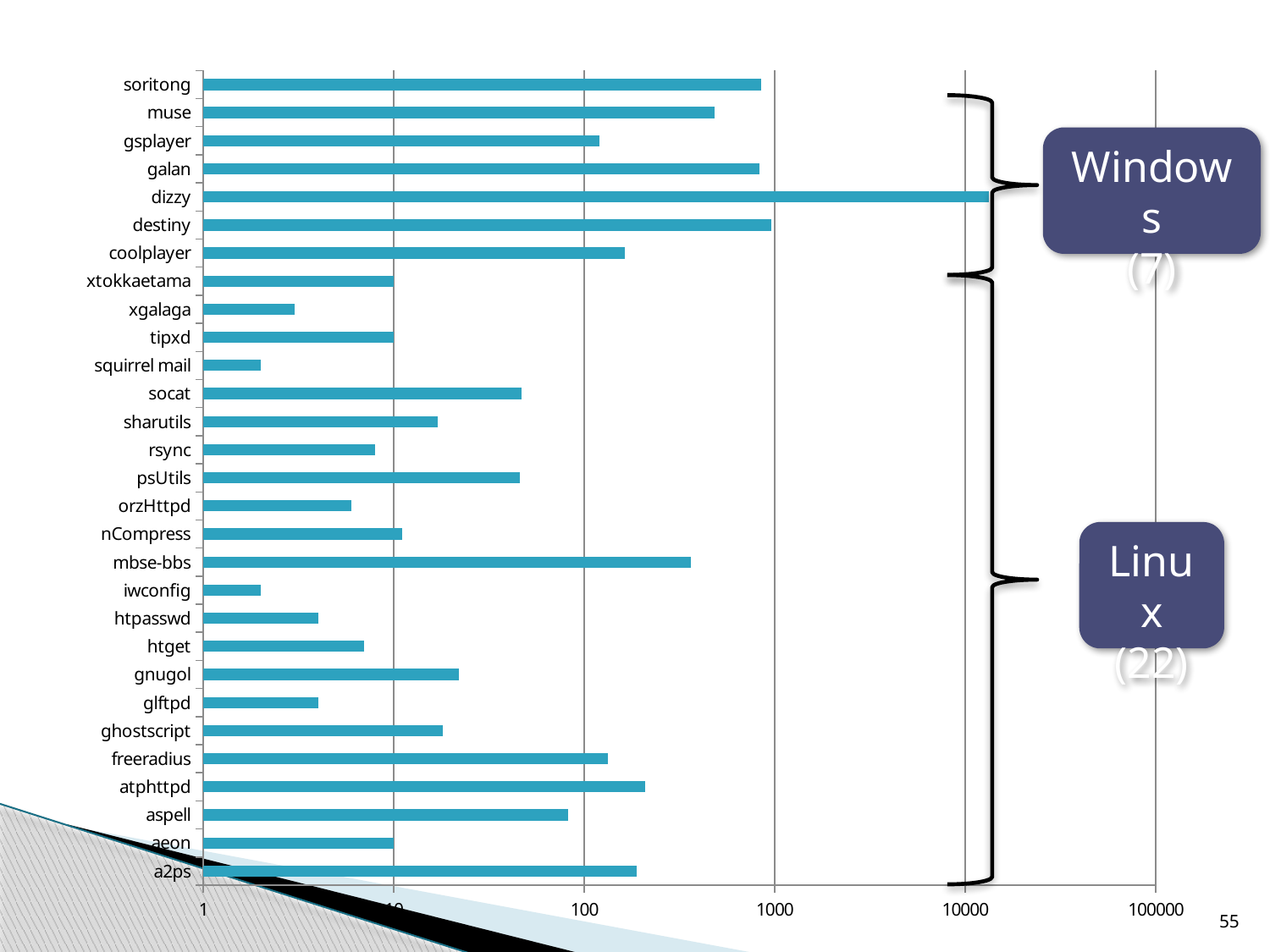
What kind of chart is shown on the slide? bar chart According to the labels beside the chart, how many programs are in the Linux group? 22 Is the value for dizzy greater or less than 10000? greater Is the value for xgalaga greater or less than 10? less Is the value for soritong greater or less than 1000? less Which has the larger value, mbse-bbs or socat? mbse-bbs How many categories (programs) are listed on the vertical axis of the chart? 29 Which has the larger value, freeradius or ghostscript? freeradius Which program has the highest value in the chart? dizzy